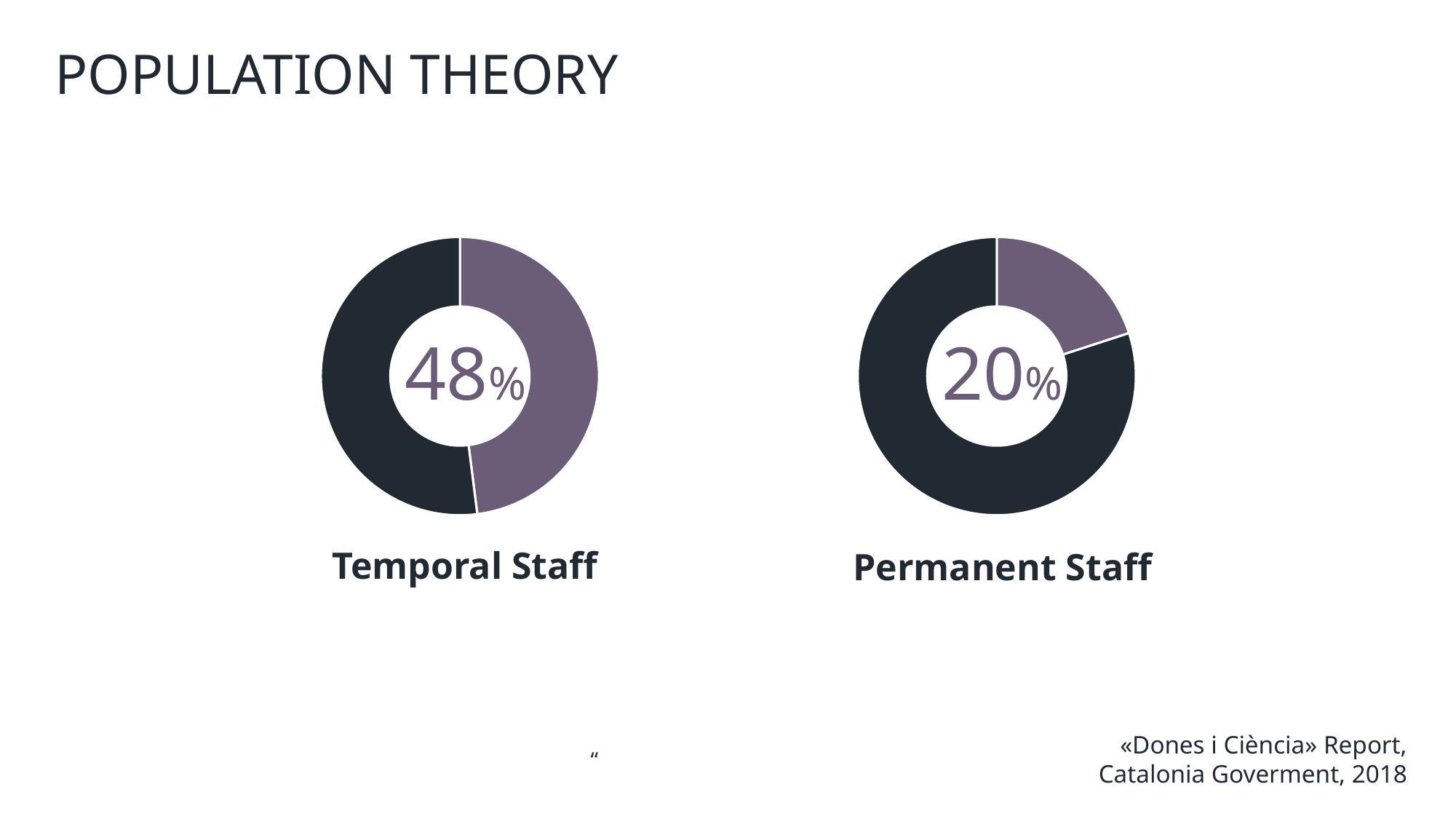
In the Permanent Staff chart, what share of the ring does the purple slice represent? 20% What percentage is shown in the centre of the Permanent Staff chart? 20% Which chart shows the higher percentage, Temporal Staff or Permanent Staff? Temporal Staff Which chart shows the lower percentage, Temporal Staff or Permanent Staff? Permanent Staff In the Permanent Staff chart, is the purple slice larger or smaller than the dark slice? smaller In the Temporal Staff chart, what share of the ring does the purple slice represent? 48% What is the label under the left-hand donut chart? Temporal Staff How many donut charts are shown on the slide? 2 What is the difference in percentage points between the Temporal Staff value and the Permanent Staff value? 28 What kind of chart is used for Temporal Staff and Permanent Staff? Donut (pie) chart How many slices does the Permanent Staff donut chart have? 2 What percentage is shown in the centre of the Temporal Staff chart? 48%